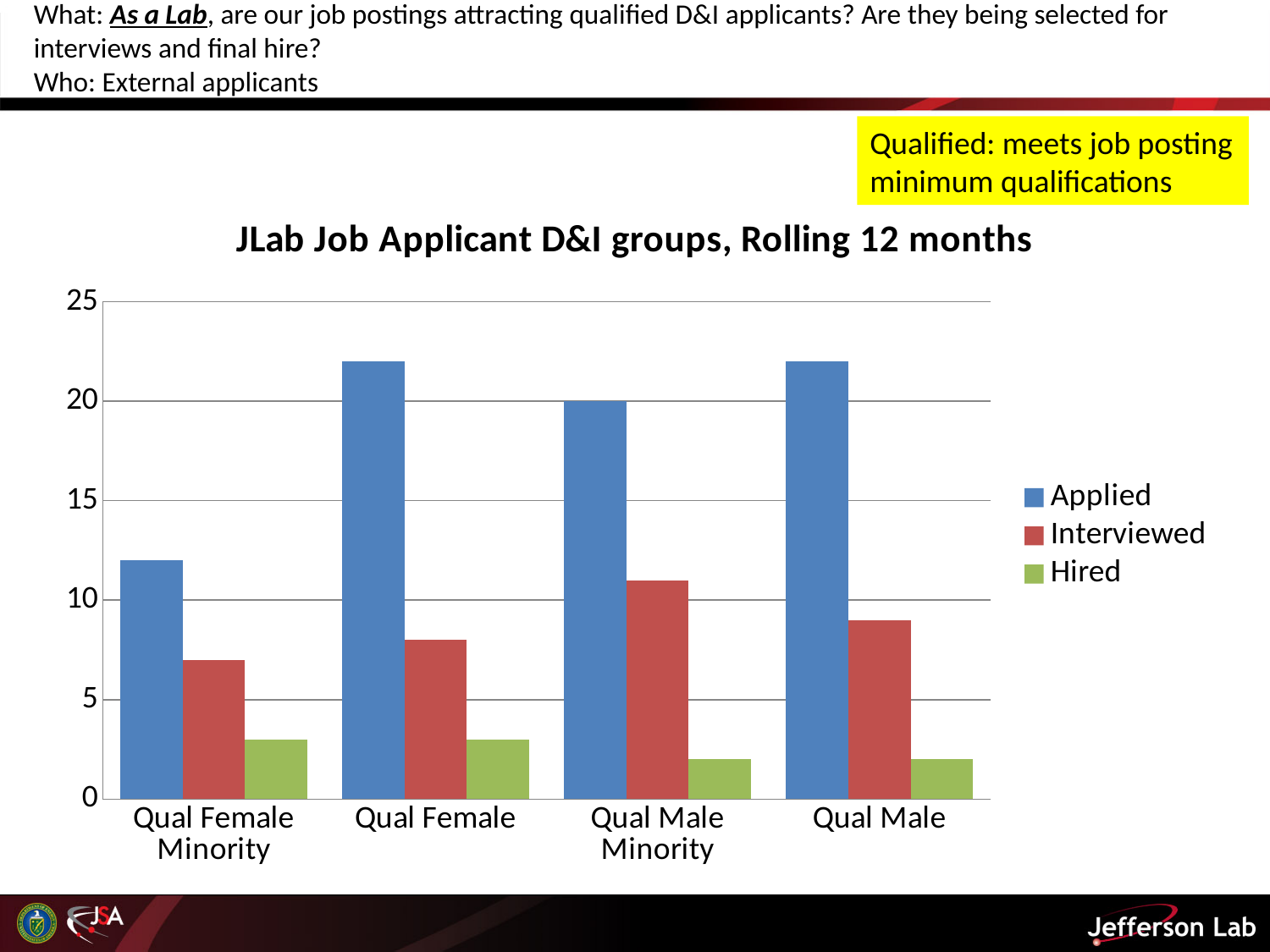
What is the title of the chart? JLab Job Applicant D&I groups, Rolling 12 months Which category has the lowest Applied value? Qual Female Minority Which series is shown in green in the legend? Hired Is the Applied value for Qual Female greater or less than 20? greater Is the Hired value for Qual Male greater or less than 5? less Which category has the highest Interviewed value? Qual Male Minority Is the Interviewed value for Qual Female Minority greater or less than 5? greater How many categories are shown on the x axis? 4 What kind of chart is shown on the slide? bar chart What is the Applied value for Qual Male Minority? 20 How many series does the legend list? 3